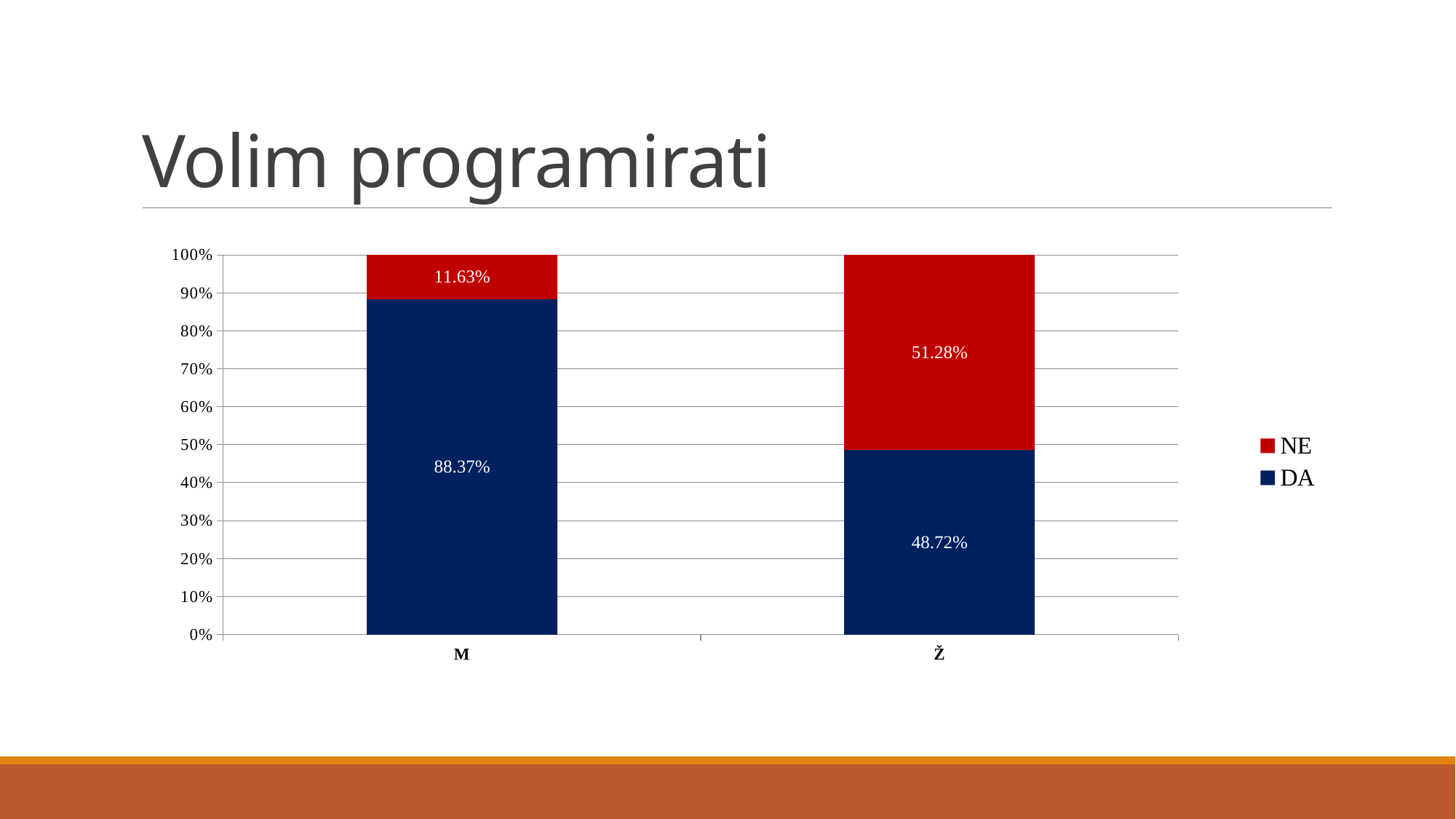
How many categories are shown on the x axis? 2 What is the difference between the NE values for Ž and M? 39.65% What is the DA value for M? 88.37% Which category has the highest NE value? Ž Which category has the lowest DA value? Ž Which category has the higher DA value, M or Ž? M What kind of chart is shown on the slide? Stacked bar chart What is the NE value for Ž? 51.28% What is the NE value for M? 11.63% How many series does the legend list? 2 What is the DA value for Ž? 48.72% What is the difference between the DA values for M and Ž? 39.65%